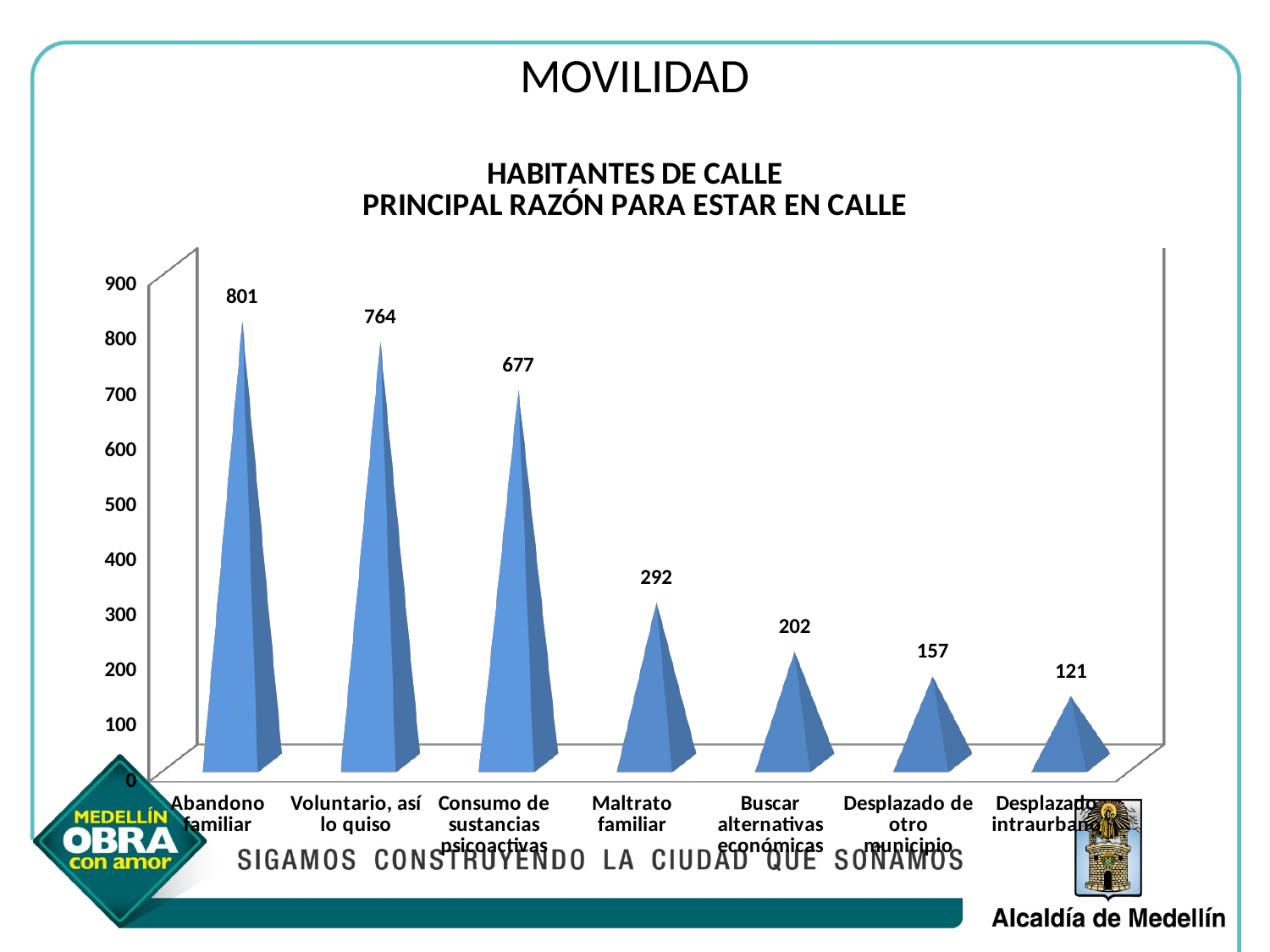
Which category has the highest value? Abandono familiar What is the value for Buscar alternativas económicas? 202 What is the value for Maltrato familiar? 292 What is the value for Abandono familiar? 801 How many categories are shown in the chart? 7 What is the difference between the values for Abandono familiar and Voluntario, así lo quiso? 37 What is the difference between the values for Consumo de sustancias psicoactivas and Maltrato familiar? 385 What is the title of the chart? HABITANTES DE CALLE PRINCIPAL RAZÓN PARA ESTAR EN CALLE Which category has the lowest value? Desplazado intraurbano Which is larger, the value for Desplazado de otro municipio or the value for Buscar alternativas económicas? Buscar alternativas económicas Is the value for Consumo de sustancias psicoactivas greater or less than 600? greater What kind of chart is shown on the slide? Bar chart